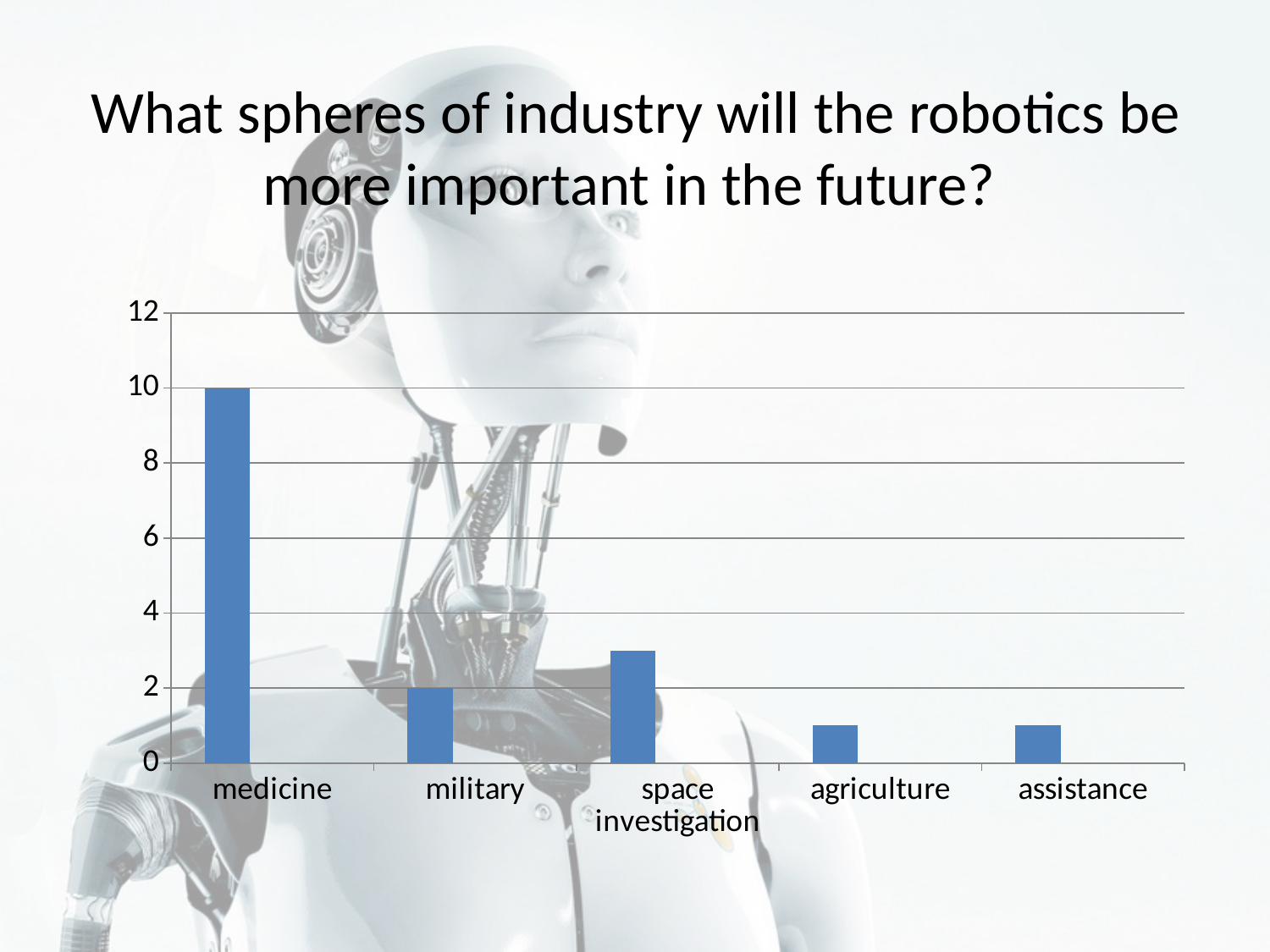
What is the value for medicine? 10 How many categories are shown on the x axis of the chart? 5 What colour are the bars in the chart? blue What is the difference between the values for medicine and military? 8 Is the value for space investigation greater or less than 2? greater Which is larger, the value for space investigation or the value for military? space investigation Which is larger, the value for medicine or the value for military? medicine What kind of chart is shown on the slide? bar chart Is the value for space investigation greater or less than 4? less Is the value for agriculture greater or less than 2? less Which category has the highest value? medicine What is the value for military? 2